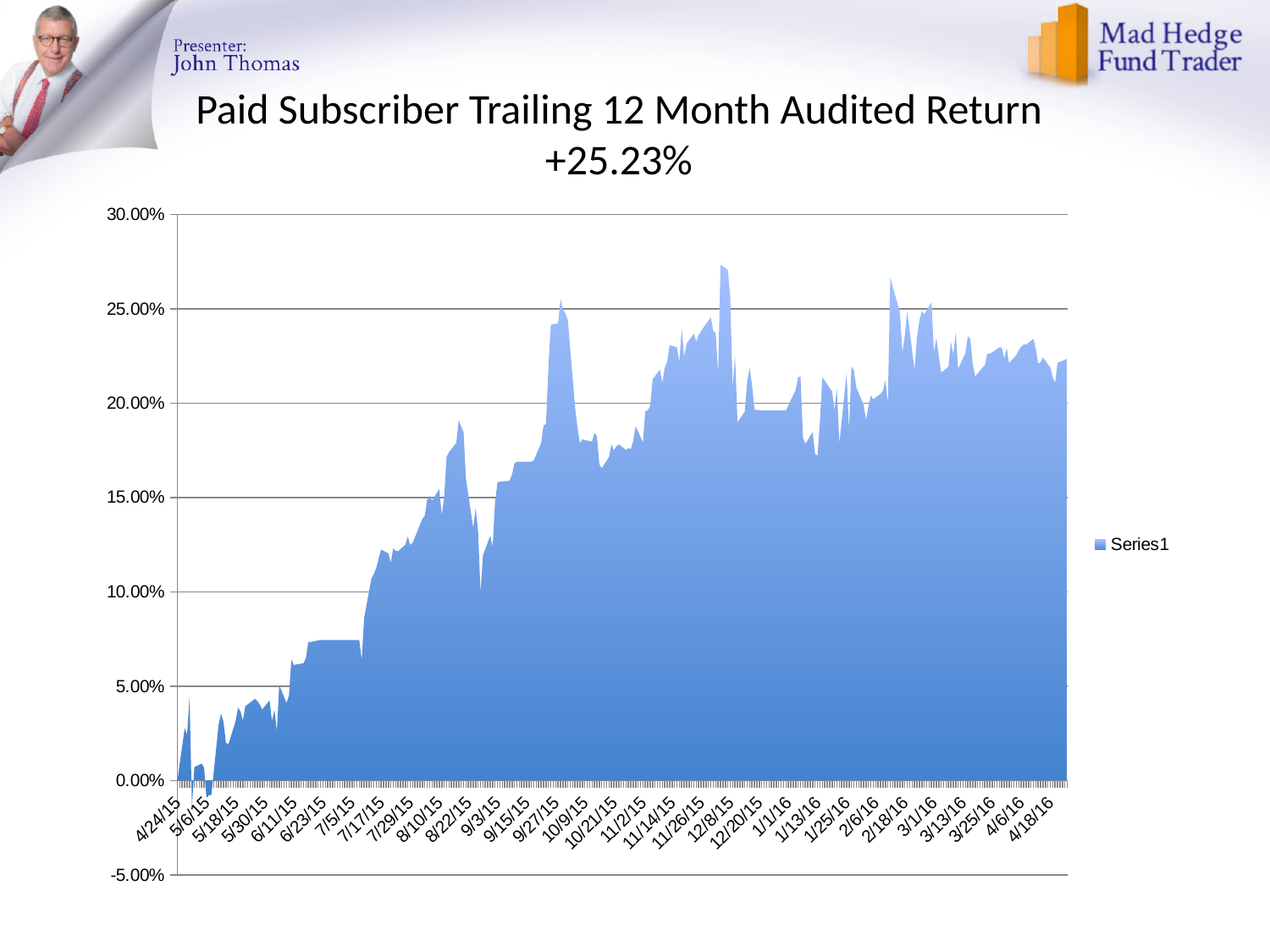
Is the value for 10/9/15 greater or less than 15.00%? greater What return figure is stated in the chart title? +25.23% What is the name of the series shown in the legend? Series1 How many series does the legend list? 1 Is the value for 4/24/15 greater or less than 5.00%? less Is the value for 4/18/16 greater or less than 20.00%? greater Which is larger, the value for 4/24/15 or the value for 4/18/16? 4/18/16 What kind of chart is shown on the slide? area chart Overall, do the values rise or fall from 4/24/15 to 4/18/16? rise